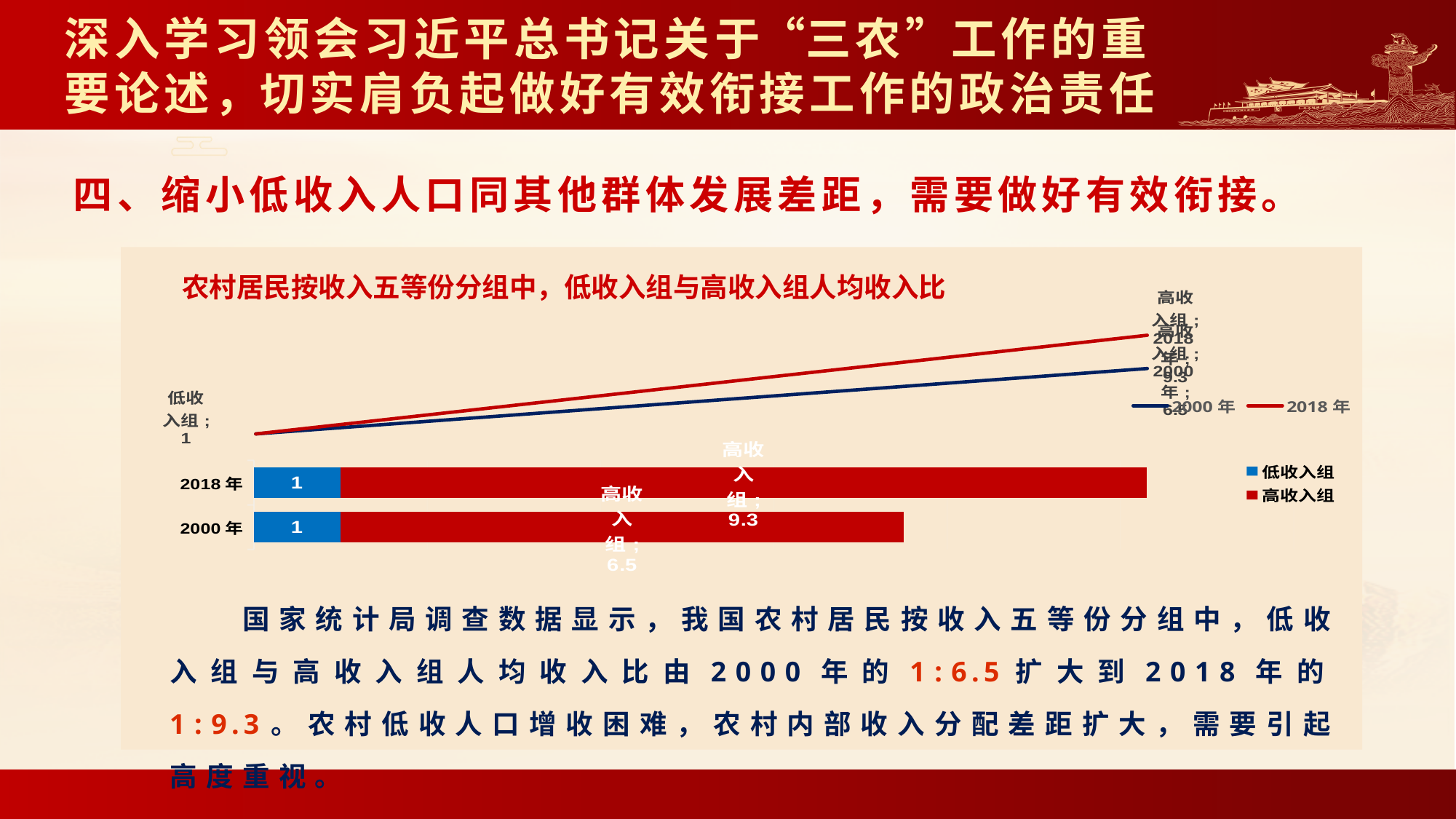
In the line chart at the top of the chart area, which series does the red line represent? 2018 年 What is the title of the chart area on the slide? 农村居民按收入五等份分组中，低收入组与高收入组人均收入比 What kind of chart is shown at the bottom of the chart area? Bar chart In the bar chart at the bottom of the chart area, how many year categories are shown? 2 In the bar chart at the bottom of the chart area, what is the total of the stacked bar for 2000年? 7.5 In the bar chart at the bottom of the chart area, what is the value of 低收入组 for 2018年? 1 In the bar chart at the bottom of the chart area, which year has the larger 高收入组 value, 2000年 or 2018年? 2018年 In the bar chart at the bottom of the chart area, how many series does the legend list? 2 In the bar chart at the bottom of the chart area, what is the total of the stacked bar for 2018年? 10.3 In the bar chart at the bottom of the chart area, what is the value of 高收入组 for 2018年? 9.3 In the bar chart at the bottom of the chart area, what is the value of 高收入组 for 2000年? 6.5 In the bar chart at the bottom of the chart area, what is the difference between the 高收入组 values for 2018年 and 2000年? 2.8